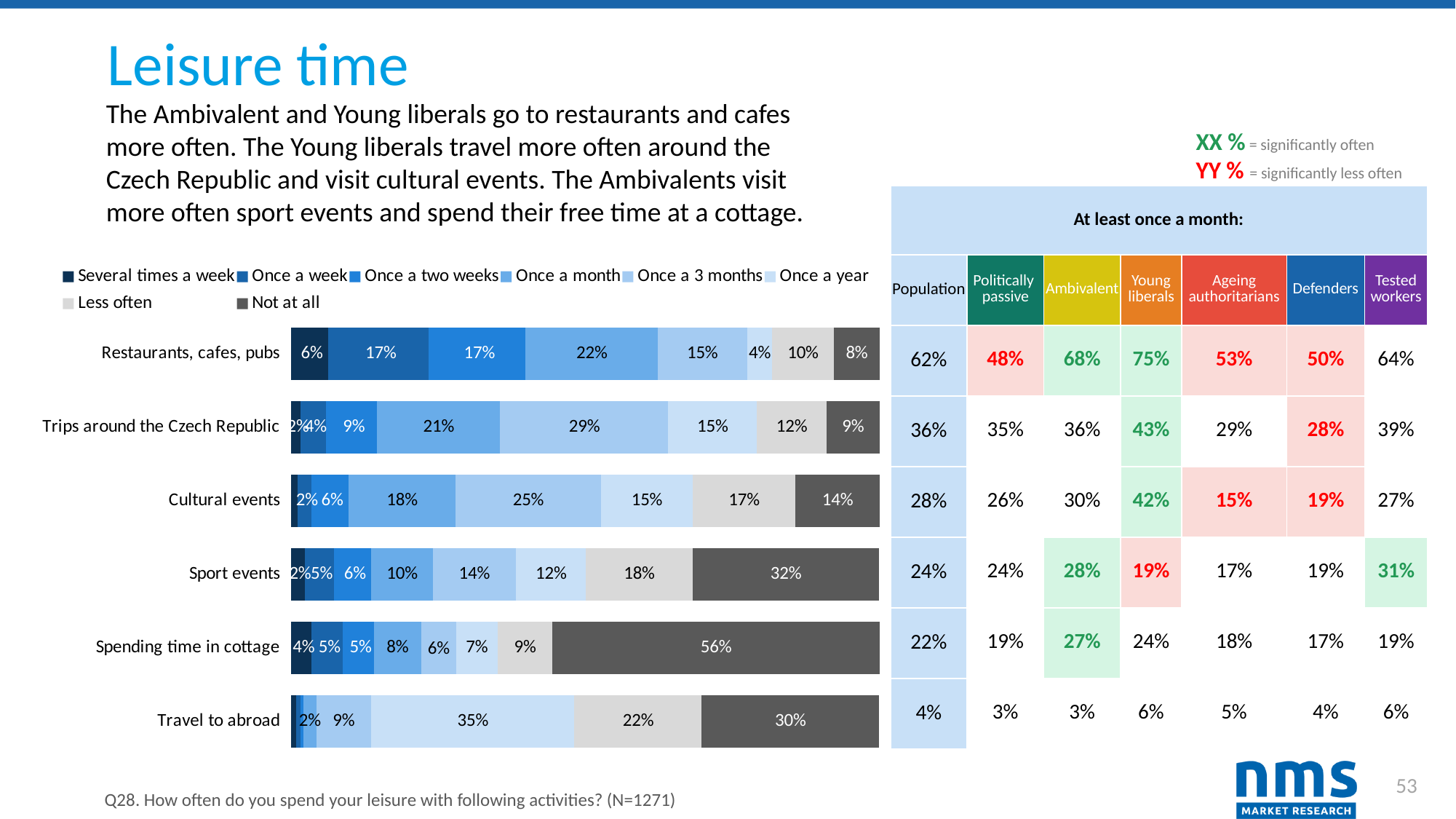
What is the "Less often" value for Travel to abroad? 22% Which has a larger "Once a week" share: Restaurants, cafes, pubs or Trips around the Czech Republic? Restaurants, cafes, pubs What percentage go to Restaurants, cafes, pubs several times a week? 6% What is the "Once a month" value for Trips around the Czech Republic? 21% What percentage of respondents answered "Not at all" for Spending time in cottage? 56% What type of chart is used to show the leisure activity frequencies? Stacked bar chart How many frequency categories does the chart legend list? 8 Which activity has the smallest "Not at all" share? Restaurants, cafes, pubs How many leisure activities are shown in the bar chart? 6 What is the difference in percentage points between the "Not at all" values for Spending time in cottage and Sport events? 24 percentage points What is the "Not at all" value for Sport events? 32% Which activity has the largest "Not at all" share? Spending time in cottage